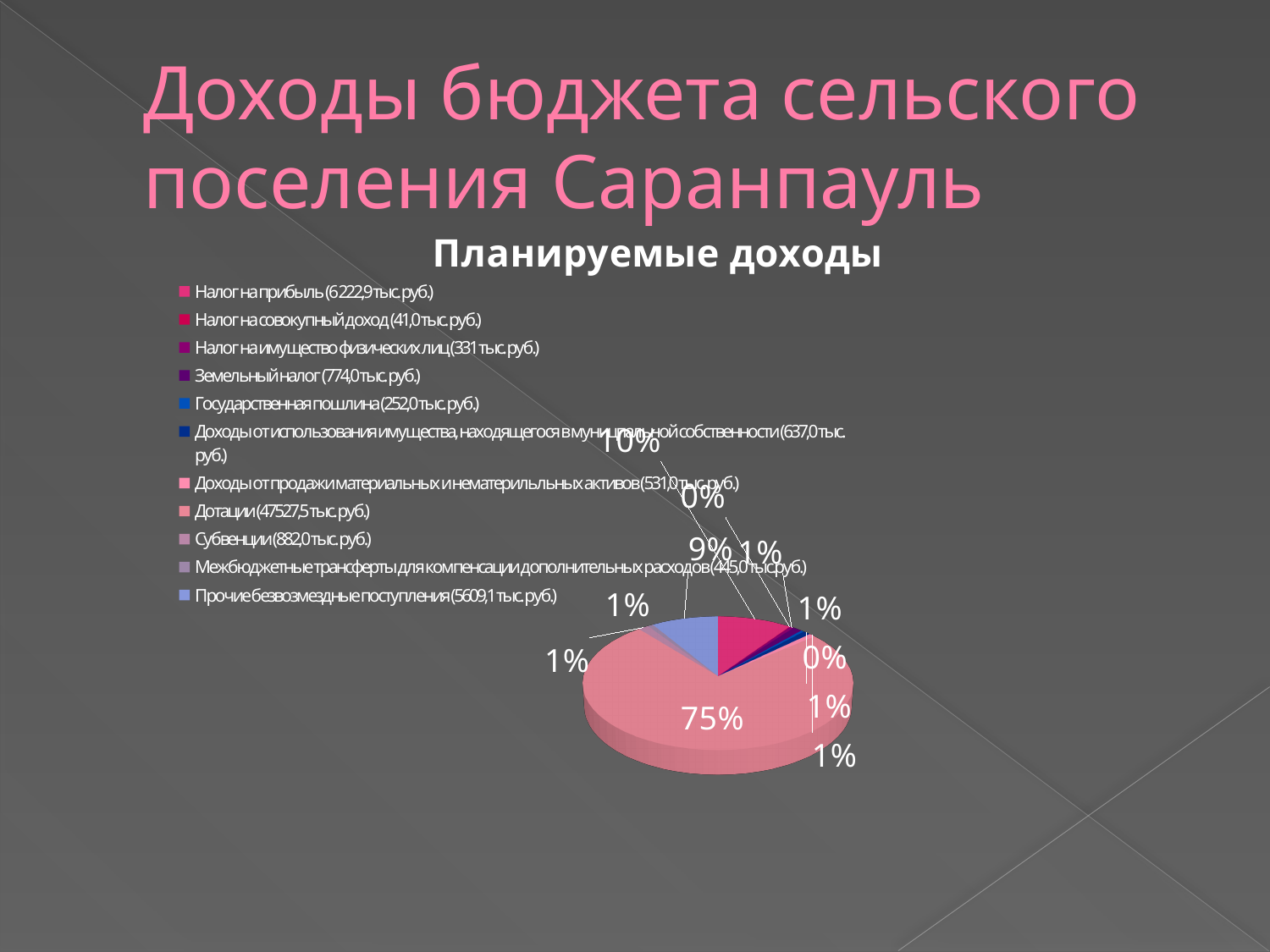
What value is given in the legend for Прочие безвозмездные поступления? 5609,1 тыс.руб. Which is larger according to the legend values: Земельный налог or Государственная пошлина? Земельный налог Which category has the smallest value according to the legend? Налог на совокупный доход What value is given in the legend for Субвенции? 882,0 тыс.руб. Which category has the largest share of the pie? Дотации What is the title of the chart? Планируемые доходы How many categories does the chart's legend list? 11 What kind of chart is shown on the slide? pie chart What value is given in the legend for Дотации? 47527,5 тыс.руб. What share of the pie does the largest slice represent? 75% What value is given in the legend for Налог на прибыль? 6222,9 тыс.руб.